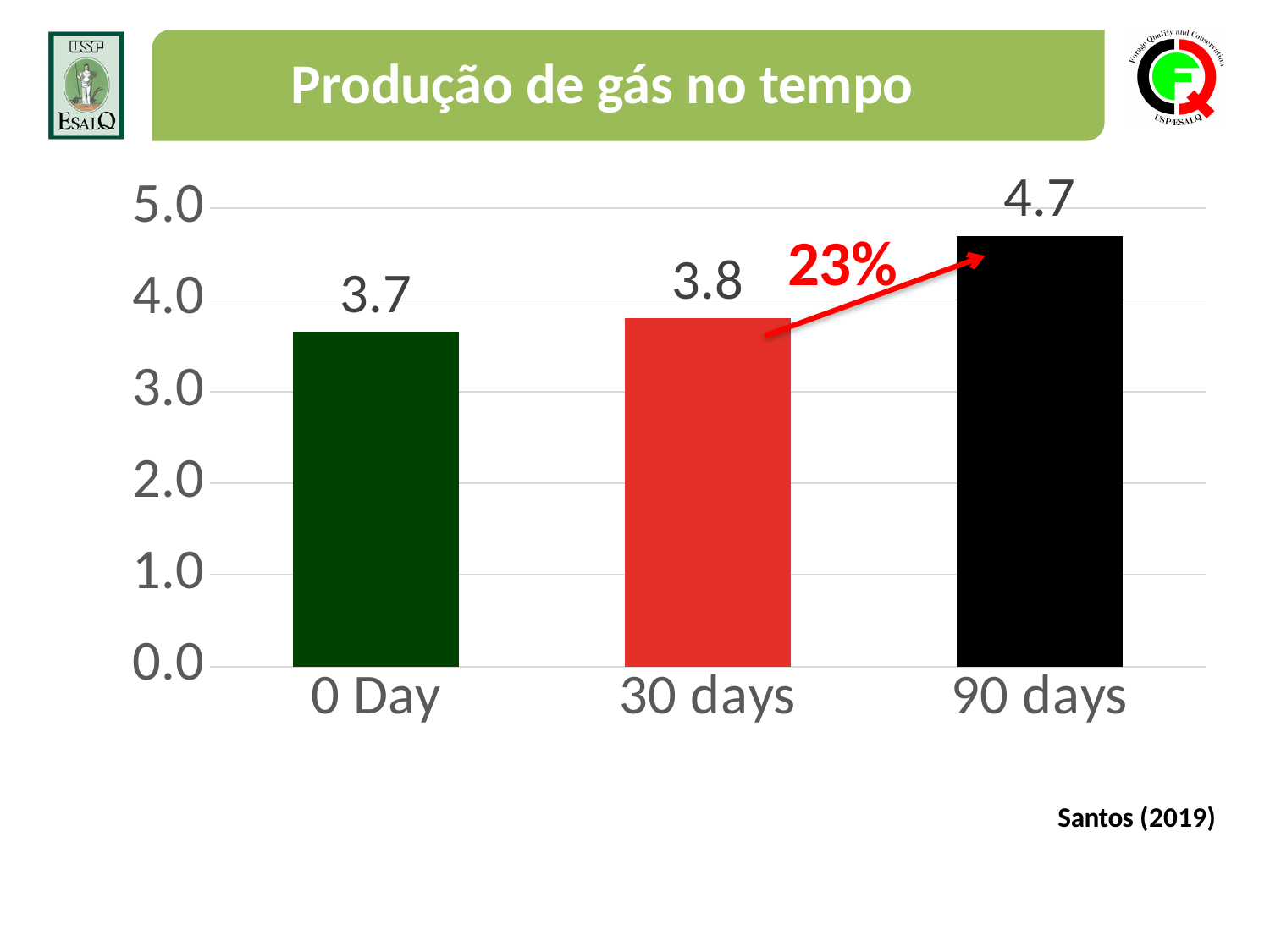
What is the value for 90 days? 4.7 Which category has the highest value? 90 days What is the title of the slide? Produção de gás no tempo Which category has the lowest value? 0 Day What kind of chart is shown on the slide? bar chart What is the value for 0 Day? 3.7 What is the difference between the values for 90 days and 30 days? 0.9 Which is larger, the value for 90 days or the value for 0 Day? 90 days What is the value for 30 days? 3.8 Is the value for 90 days greater or less than 4.0? greater What is the difference between the values for 90 days and 0 Day? 1.0 How many categories are shown on the x axis? 3